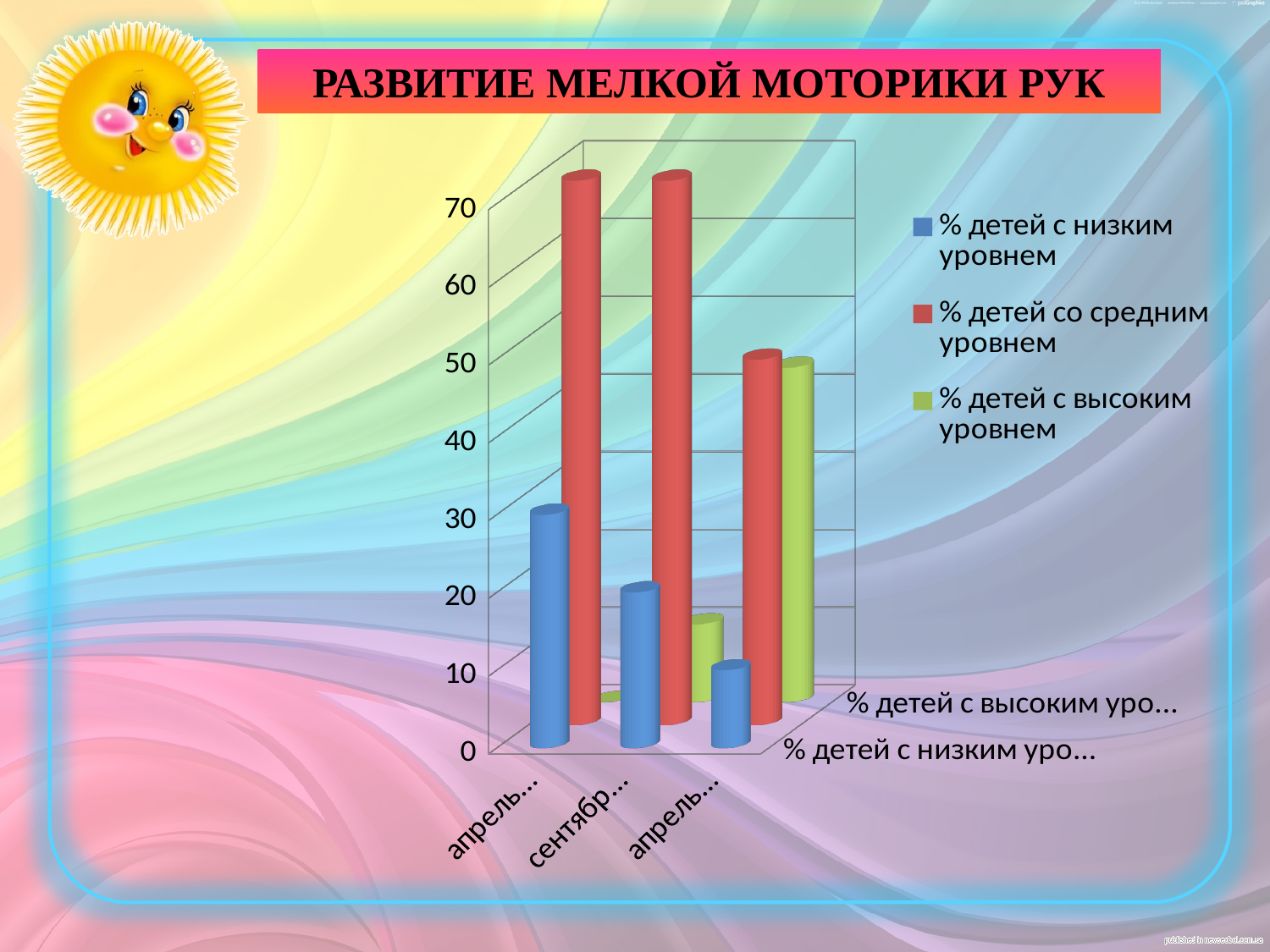
Which series has the highest value in the leftmost category? % детей со средним уровнем Is the value of "% детей с высоким уровнем" for the middle category (сентябр…) greater or less than 30? less Which colour represents the series "% детей с высоким уровнем" in the legend? green What is the title shown above the chart? РАЗВИТИЕ МЕЛКОЙ МОТОРИКИ РУК How many categories are shown along the x axis? 3 Is the value of "% детей со средним уровнем" for the leftmost category greater or less than 60? greater What kind of chart is shown on the slide? bar chart Do the values of "% детей с низким уровнем" rise or fall from the leftmost category to the rightmost category? fall In the middle category (сентябр…), which is larger: "% детей с низким уровнем" or "% детей со средним уровнем"? % детей со средним уровнем Is the value of "% детей с низким уровнем" for the leftmost category greater or less than 20? greater How many series does the legend list? 3